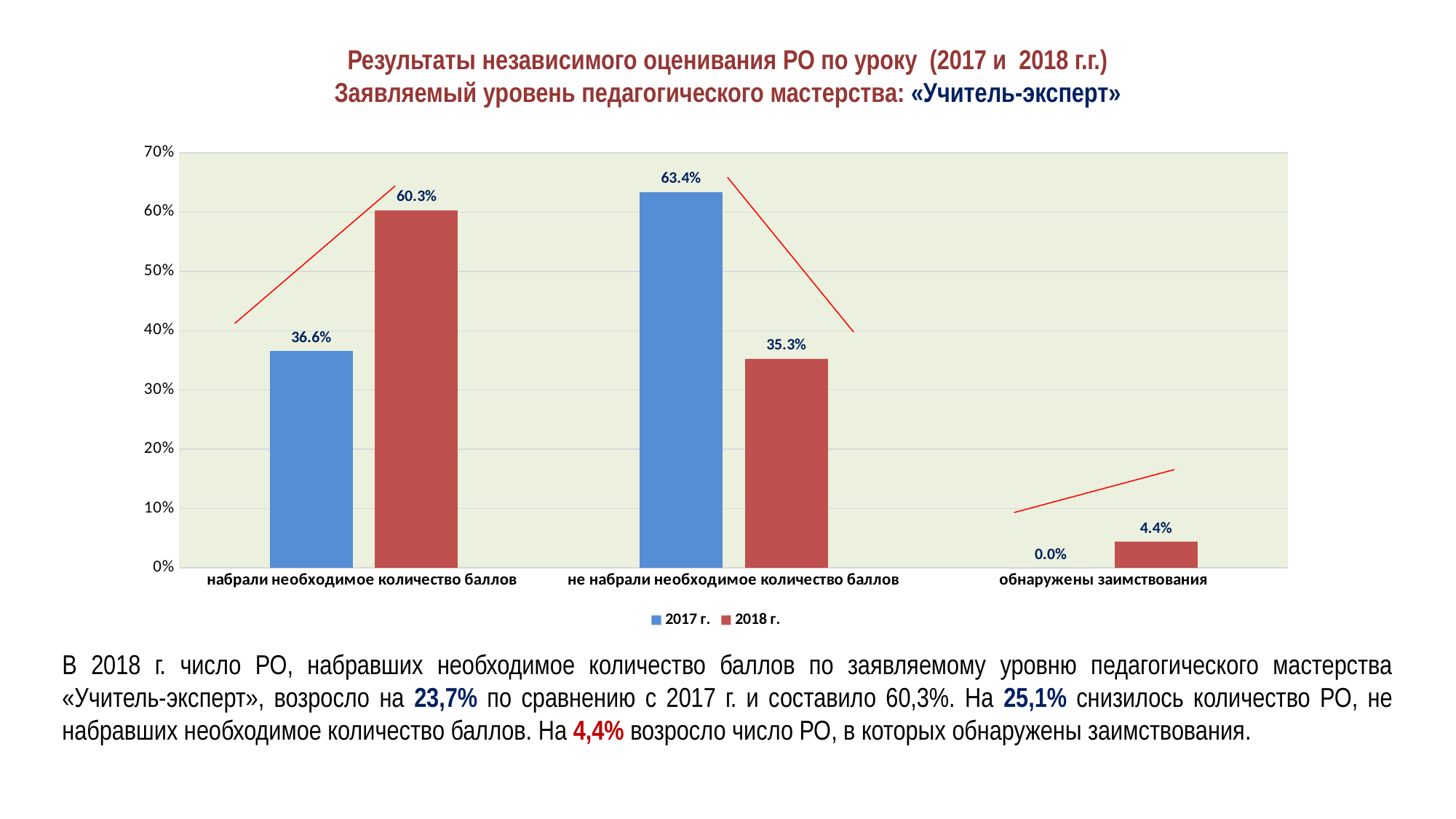
How many categories are shown on the x axis of the chart? 3 Which category has the highest value for the 2018 г. series? набрали необходимое количество баллов How many series does the chart legend list? 2 What is the value for 2017 г. in the category «не набрали необходимое количество баллов»? 63.4% Which is larger in the category «не набрали необходимое количество баллов»: the 2017 г. value or the 2018 г. value? 2017 г. What is the value for 2018 г. in the category «обнаружены заимствования»? 4.4% What kind of chart is shown on the slide? bar chart What is the difference between the 2018 г. and 2017 г. values in the category «набрали необходимое количество баллов»? 23.7% Which category has the lowest value for the 2017 г. series? обнаружены заимствования What is the value for 2018 г. in the category «набрали необходимое количество баллов»? 60.3% What is the value for 2017 г. in the category «набрали необходимое количество баллов»? 36.6% Which colour represents the 2018 г. series in the chart? red